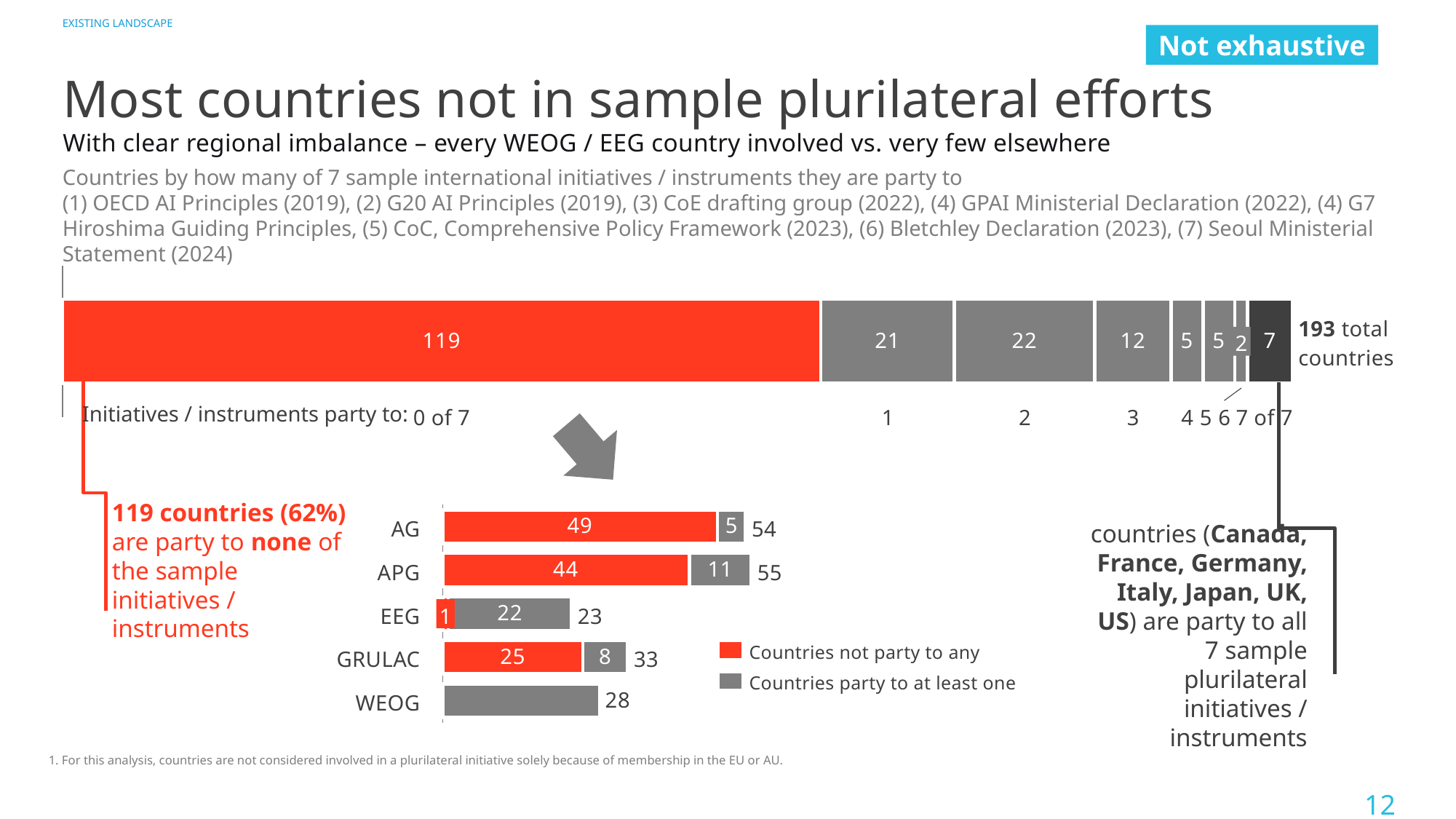
In the bottom chart by regional group, which regional group has the lowest number of countries not party to any initiative? WEOG In the top bar showing countries by how many initiatives they are party to, how many countries are party to 0 of 7? 119 In the bottom chart by regional group, how many series does the legend list? 2 In the top bar showing countries by how many initiatives they are party to, what is the total number of countries? 193 In the top bar showing countries by how many initiatives they are party to, how many countries are party to all 7 of 7? 7 In the bottom chart by regional group, how many AG countries are not party to any of the sample initiatives? 49 In the bottom chart by regional group, which regional group has the highest total number of countries? APG In the bottom chart by regional group, what colour represents countries not party to any initiative? Red In the top bar showing countries by how many initiatives they are party to, how many more countries are party to 2 of 7 than to 1 of 7? 1 In the top bar showing countries by how many initiatives they are party to, how many countries are party to exactly 2 of 7? 22 In the bottom chart by regional group, how many APG countries are party to at least one initiative? 11 In the bottom chart by regional group, what is the total number of GRULAC countries? 33